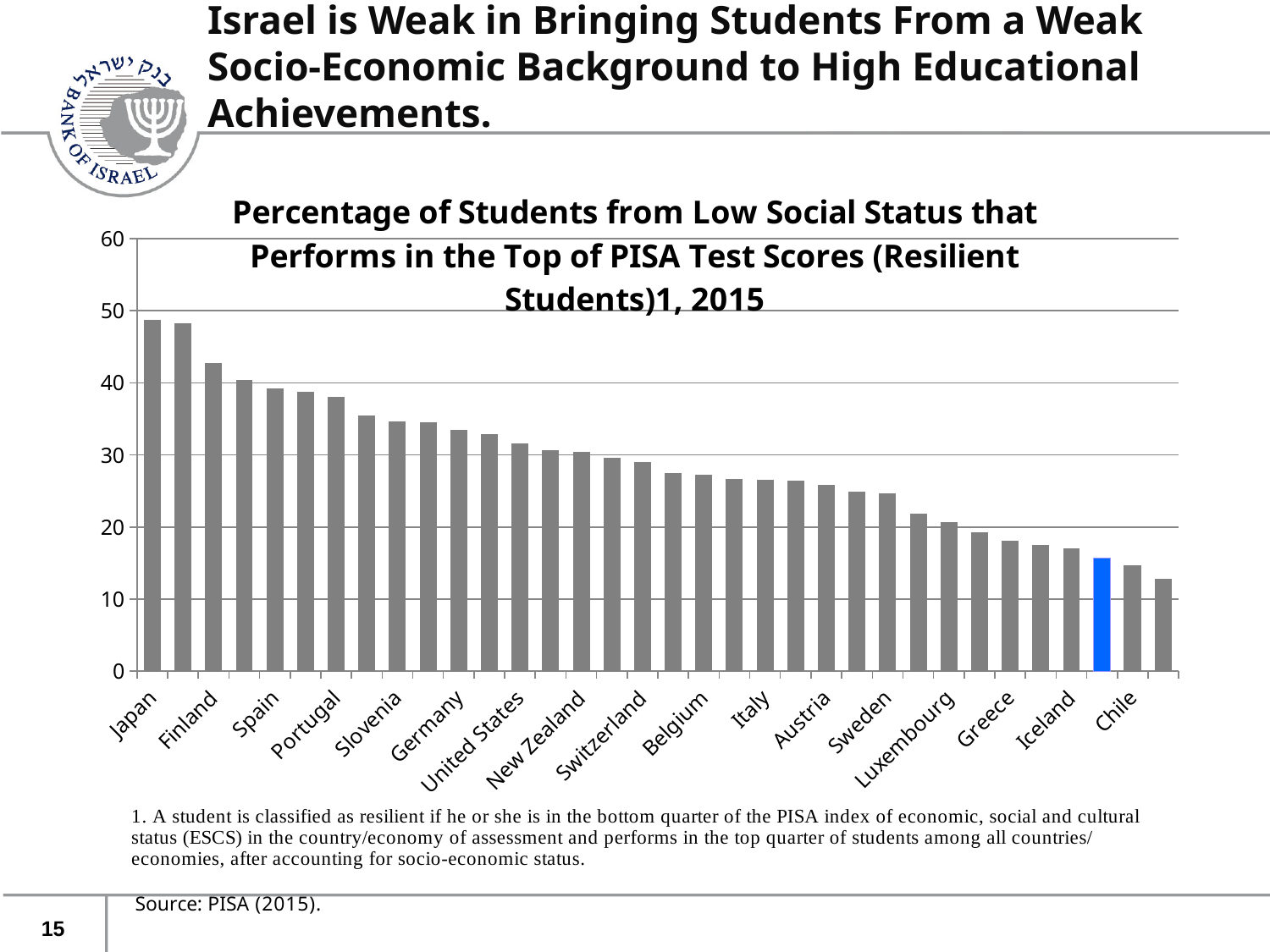
What kind of chart is shown on the slide? bar chart Is the value for Belgium greater or less than 30? less What colour is the single highlighted bar near the right end of the chart? blue Is the value for Chile greater or less than 20? less Is the value for Japan greater or less than 40? greater Which country has the highest percentage of resilient students in the chart? Japan Which has a higher value, Iceland or Slovenia? Slovenia Do the bar values rise or fall moving from left to right along the x axis? fall Which has a higher value, Finland or Greece? Finland